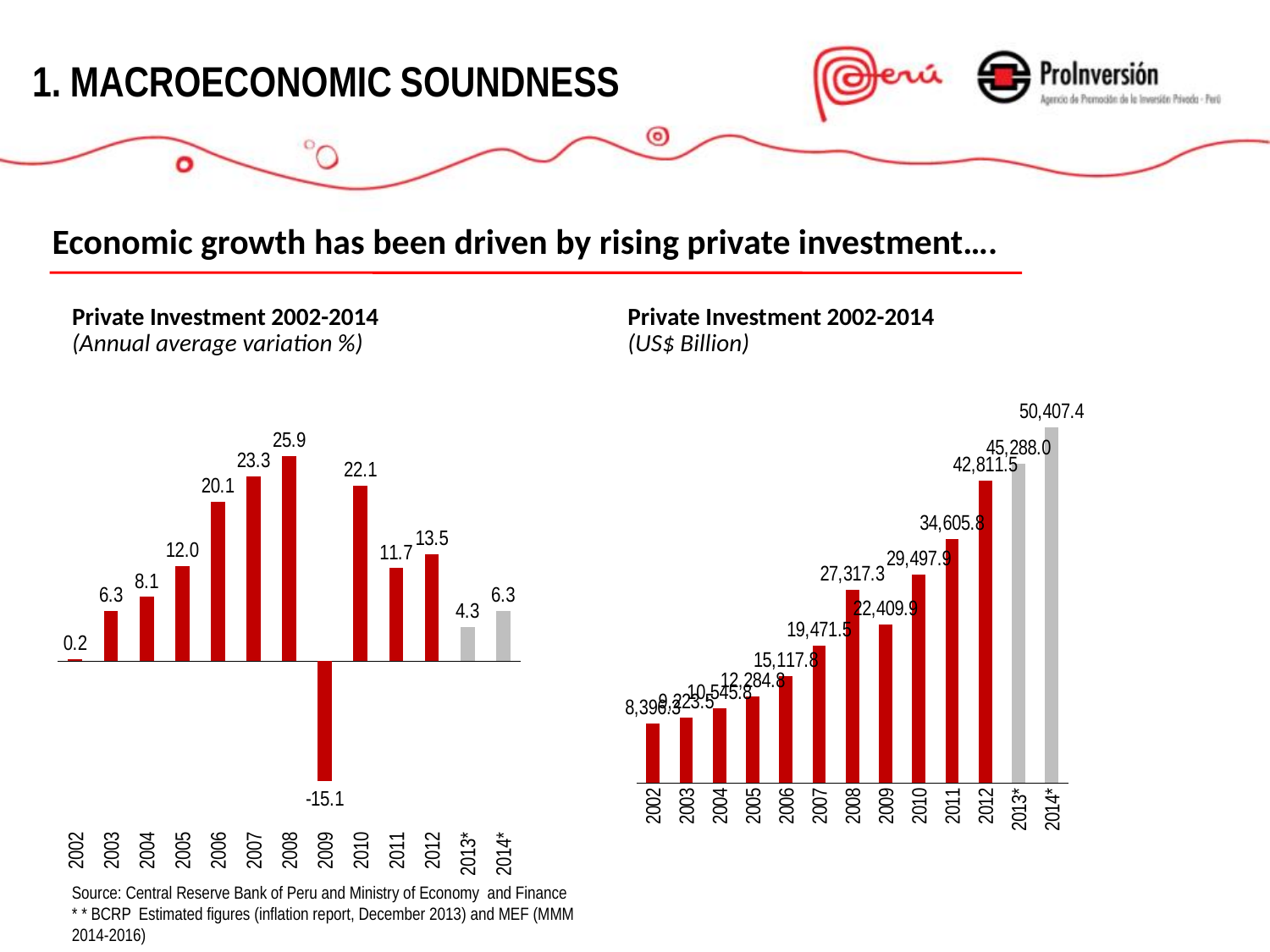
In the left chart (Annual average variation %), what is the value for 2008? 25.9 In the right chart (US$ Billion), what is the value for 2011? 34,605.8 In the left chart (Annual average variation %), what is the value for 2009? -15.1 In the left chart (Annual average variation %), which year has the lowest value? 2009 In the left chart (Annual average variation %), how many years are shown on the x axis? 13 In the right chart (US$ Billion), what is the value for 2014*? 50,407.4 What type of chart is the right chart (US$ Billion)? bar chart In the right chart (US$ Billion), which year has the highest value? 2014* In the left chart (Annual average variation %), what is the difference between the values for 2010 and 2011? 10.4 In the left chart (Annual average variation %), which is larger, the value for 2012 or the value for 2013*? 2012 In the left chart (Annual average variation %), which year has the highest value? 2008 In the right chart (US$ Billion), do the values rise or fall from 2002 to 2014*? rise